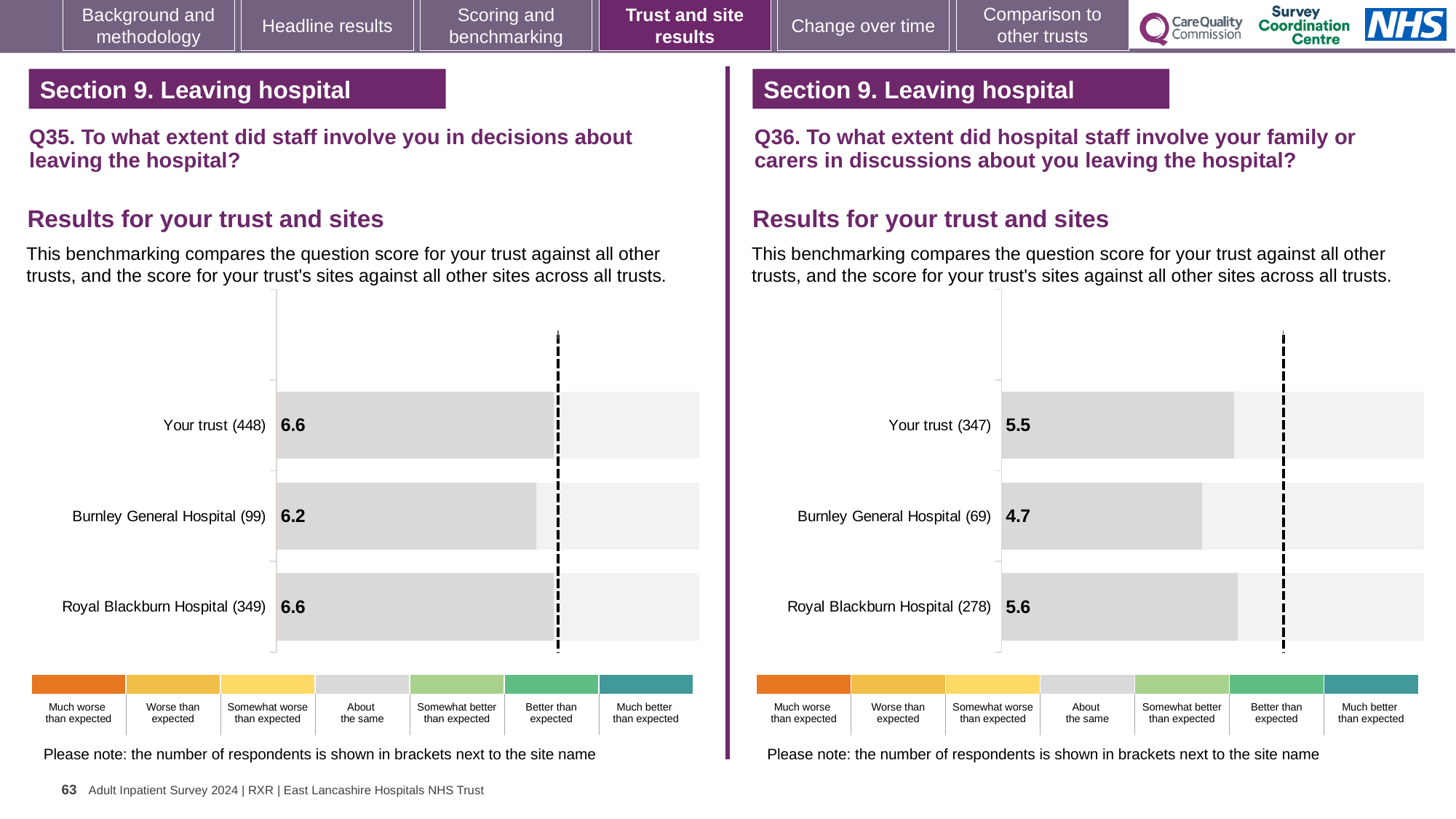
In the Q35 chart on the left, what is the difference between the score for Your trust and the score for Burnley General Hospital? 0.4 In the Q35 chart on the left, what is the score for Burnley General Hospital? 6.2 In the Q36 chart on the right, which has the larger score: Your trust or Burnley General Hospital? Your trust What kind of chart is used for the Q36 results on the right? Bar chart In the Q36 chart on the right, what is the score for Burnley General Hospital? 4.7 How many bars are plotted in the Q35 chart on the left? 3 In the Q35 chart on the left, which site or trust has the lowest score? Burnley General Hospital In the Q36 chart on the right, how many respondents are shown in brackets for Your trust? 347 In the Q36 chart on the right, which site or trust has the lowest score? Burnley General Hospital In the Q36 chart on the right, what is the difference between the score for Royal Blackburn Hospital and the score for Burnley General Hospital? 0.9 In the Q36 chart on the right, what is the score for Royal Blackburn Hospital? 5.6 In the Q35 chart on the left, what is the score for Your trust? 6.6